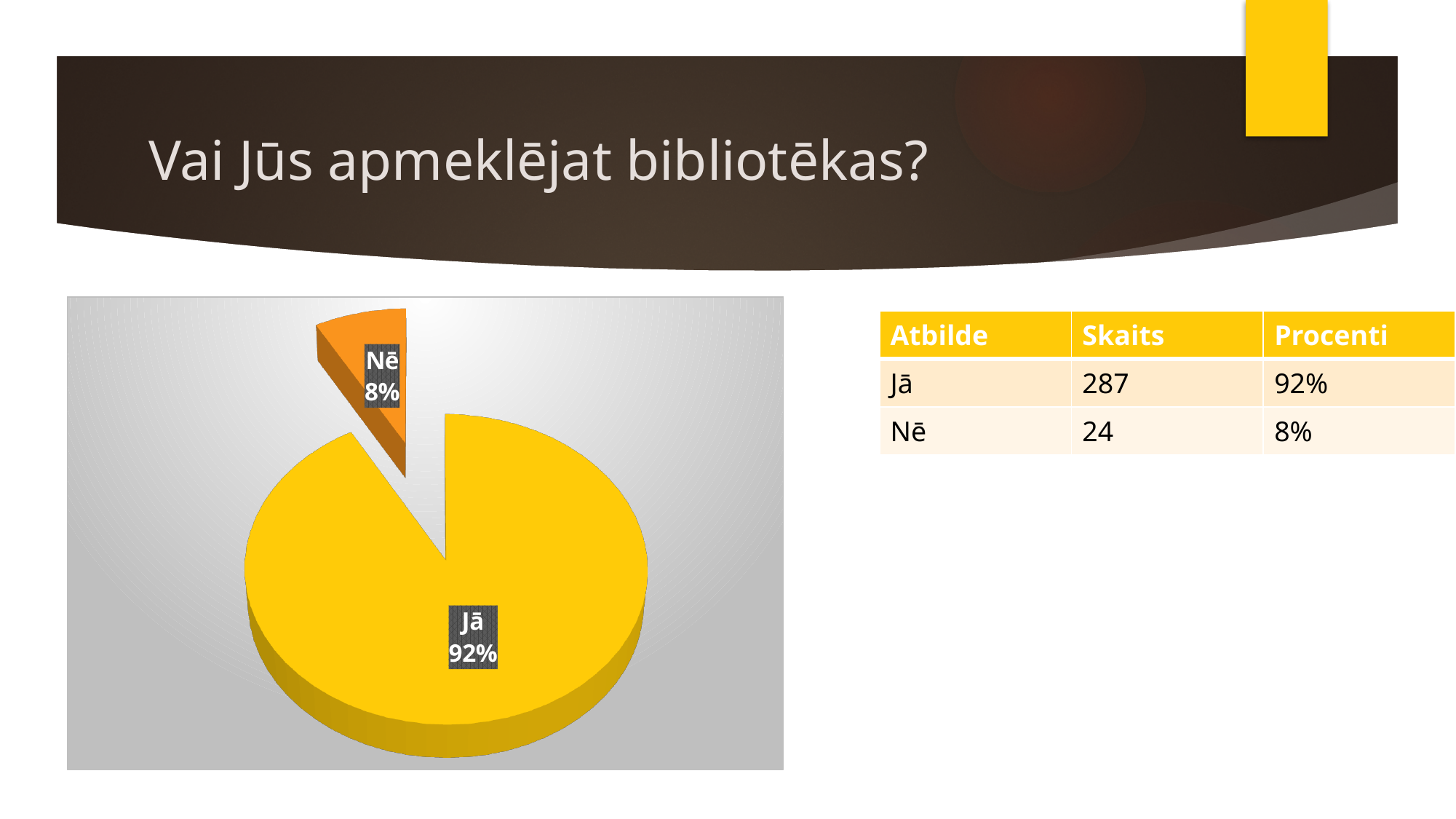
Which slice of the pie chart is the smallest? Nē What colour is the "Nē" slice in the pie chart? orange How many slices does the pie chart have? 2 What colour is the "Jā" slice in the pie chart? yellow What share of the pie does the "Nē" slice represent? 8% Which is larger in the pie chart, the "Jā" slice or the "Nē" slice? Jā Which slice of the pie chart is the largest? Jā What share of the pie does the "Jā" slice represent? 92% What is the difference in percentage points between the "Jā" and "Nē" slices? 84 percentage points What kind of chart is shown on the slide? pie chart